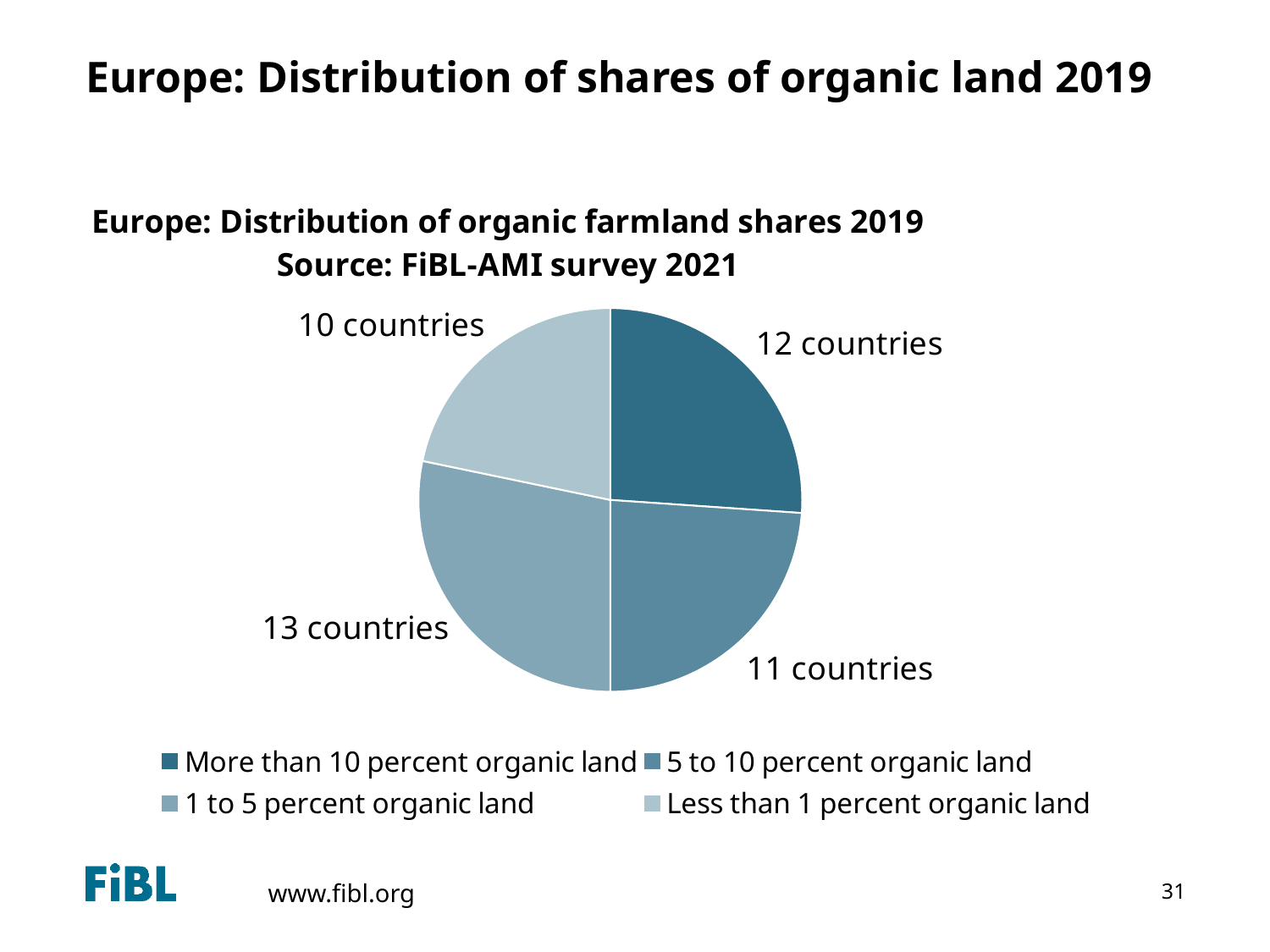
What kind of chart is shown on the slide? Pie chart Which category contains the most countries? 1 to 5 percent organic land Which category has more countries: more than 10 percent organic land or 5 to 10 percent organic land? More than 10 percent organic land How many slices does the pie chart have? 4 What source is cited in the chart title? FiBL-AMI survey 2021 How many more countries are in the 1 to 5 percent category than in the less than 1 percent category? 3 How many countries have 5 to 10 percent organic land? 11 countries What is the total number of countries represented in the pie chart? 46 How many countries have more than 10 percent organic land? 12 countries Which category contains the fewest countries? Less than 1 percent organic land How many countries have less than 1 percent organic land? 10 countries How many countries have 1 to 5 percent organic land? 13 countries